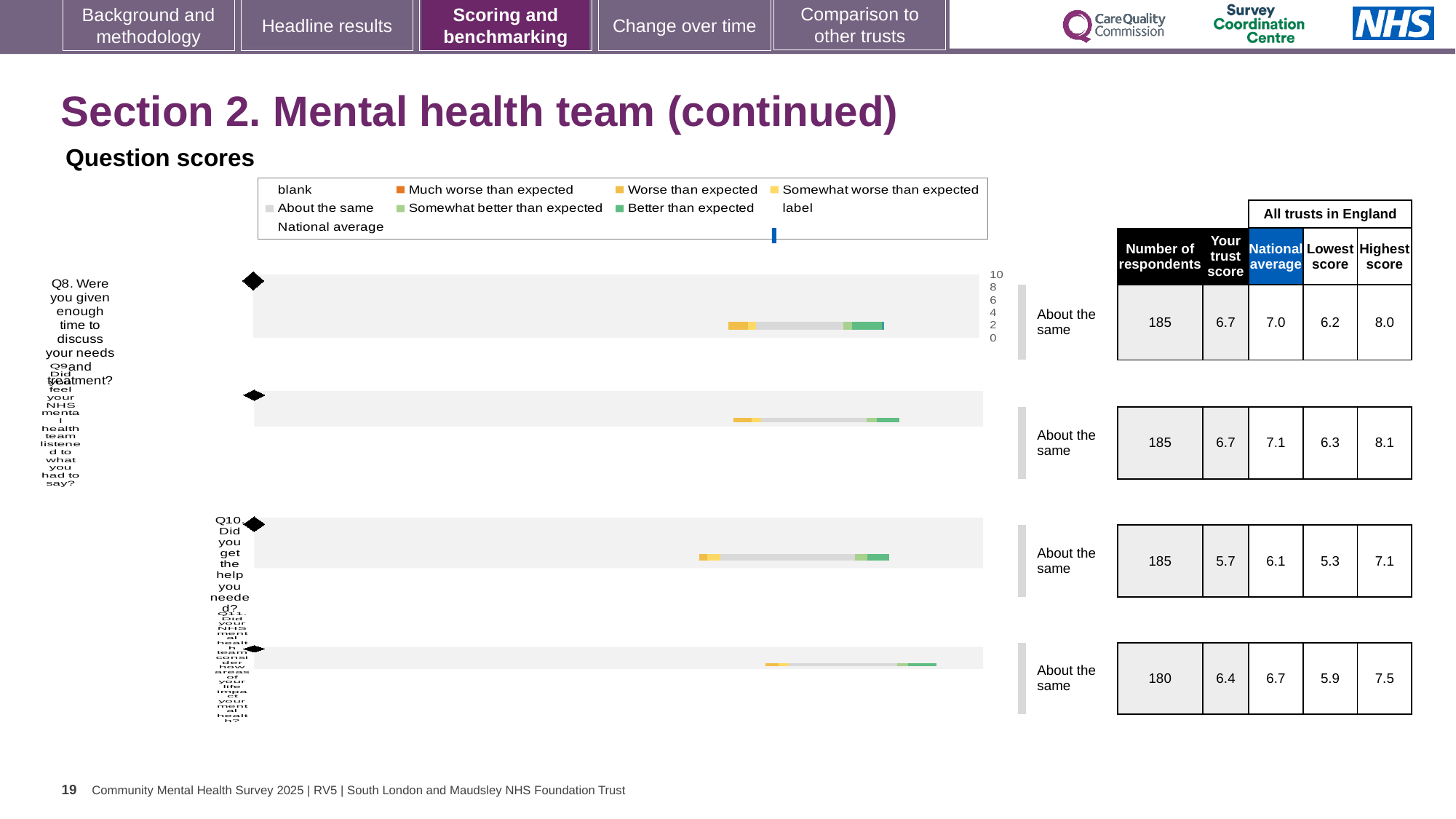
For the bottom row (Q11), how many respondents are listed? 180 What benchmark category label is shown next to each of the four question charts? About the same For Q8, what is the difference between the Highest score and the Lowest score? 1.8 For Q8, what is the National average score shown in the table? 7.0 How many question rows (charts) are shown on the slide? 4 For Q8, what is the Highest score among all trusts in England? 8.0 For Q10 (Did you get the help you needed?), what is the 'Your trust score' value? 5.7 For Q10, how many respondents are listed? 185 What kind of chart is used for the question scores on this slide? bar chart For Q10, which is larger: the trust score or the National average? National average For Q8 (Were you given enough time to discuss your needs and treatment?), what is the 'Your trust score' value in the table? 6.7 For Q10, what is the difference between the National average and the trust score? 0.4